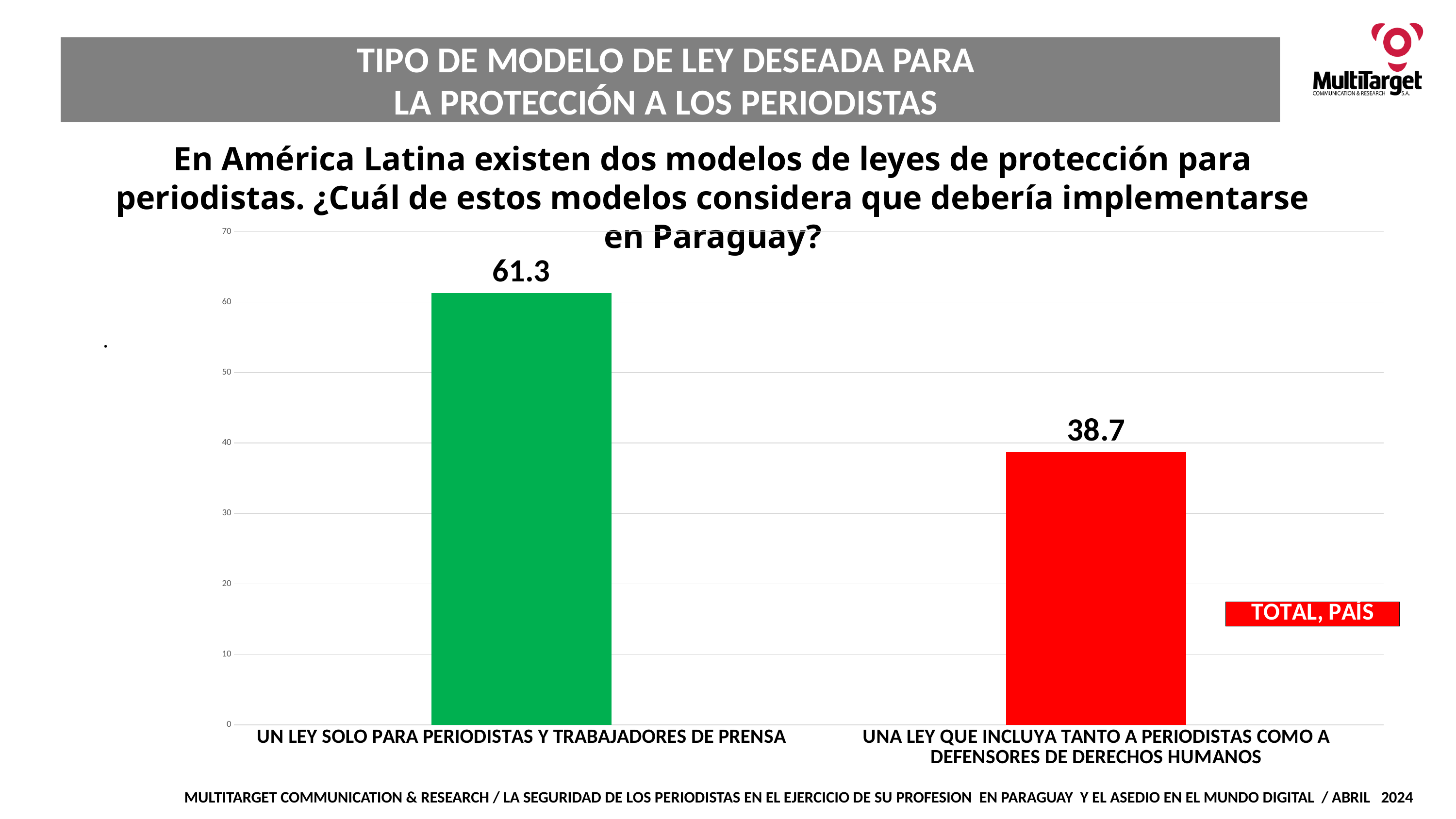
How many categories are shown in the chart? 2 Is the value for "UNA LEY QUE INCLUYA TANTO A PERIODISTAS COMO A DEFENSORES DE DERECHOS HUMANOS" greater or less than 40? less What kind of chart is shown on the slide? bar chart Which is larger: the value for "UN LEY SOLO PARA PERIODISTAS Y TRABAJADORES DE PRENSA" or the value for "UNA LEY QUE INCLUYA TANTO A PERIODISTAS COMO A DEFENSORES DE DERECHOS HUMANOS"? UN LEY SOLO PARA PERIODISTAS Y TRABAJADORES DE PRENSA What is the legend entry shown on the chart? TOTAL, PAÍS What is the value for "UNA LEY QUE INCLUYA TANTO A PERIODISTAS COMO A DEFENSORES DE DERECHOS HUMANOS"? 38.7 What is the difference between the value for "UN LEY SOLO PARA PERIODISTAS Y TRABAJADORES DE PRENSA" and the value for "UNA LEY QUE INCLUYA TANTO A PERIODISTAS COMO A DEFENSORES DE DERECHOS HUMANOS"? 22.6 Which category has the highest value? UN LEY SOLO PARA PERIODISTAS Y TRABAJADORES DE PRENSA What is the value for "UN LEY SOLO PARA PERIODISTAS Y TRABAJADORES DE PRENSA"? 61.3 Is the value for "UN LEY SOLO PARA PERIODISTAS Y TRABAJADORES DE PRENSA" greater or less than 60? greater How many series does the legend list? 1 Which category has the lowest value? UNA LEY QUE INCLUYA TANTO A PERIODISTAS COMO A DEFENSORES DE DERECHOS HUMANOS